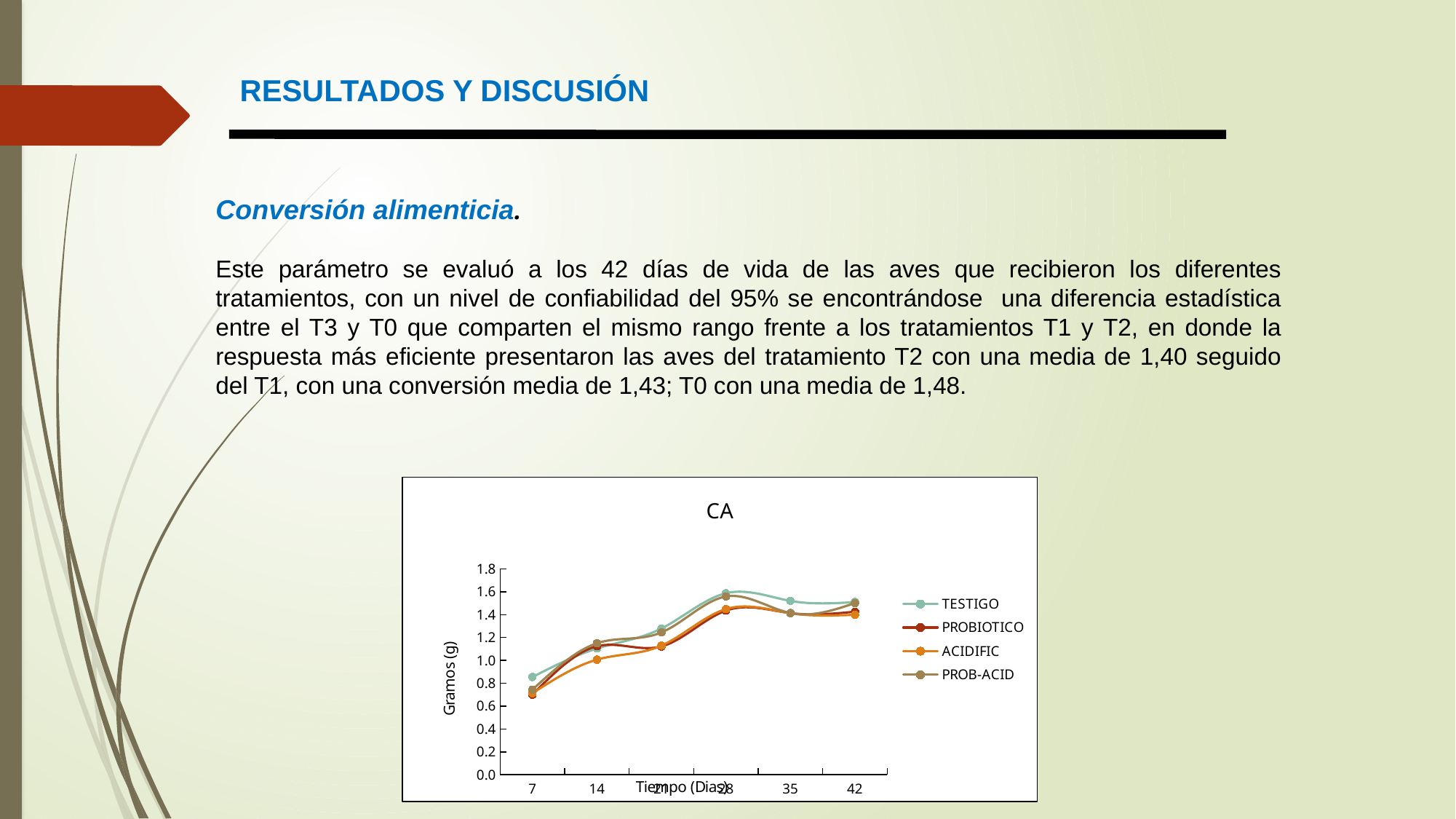
At day 7, which is larger: the value for TESTIGO or the value for ACIDIFIC? TESTIGO Is the value for TESTIGO at day 7 greater or less than 0.6? greater Does the TESTIGO series rise or fall from day 7 to day 28? rise How many time points are plotted along the x axis of the chart? 6 What is the label of the y axis of the chart? Gramos (g) What kind of chart is shown on the slide? line chart How many series does the legend of the chart list? 4 What is the title of the chart? CA Is the value for PROBIOTICO at day 42 greater or less than 1.6? less Is the value for TESTIGO at day 28 greater or less than 1.4? greater Which series has the highest value at day 7? TESTIGO